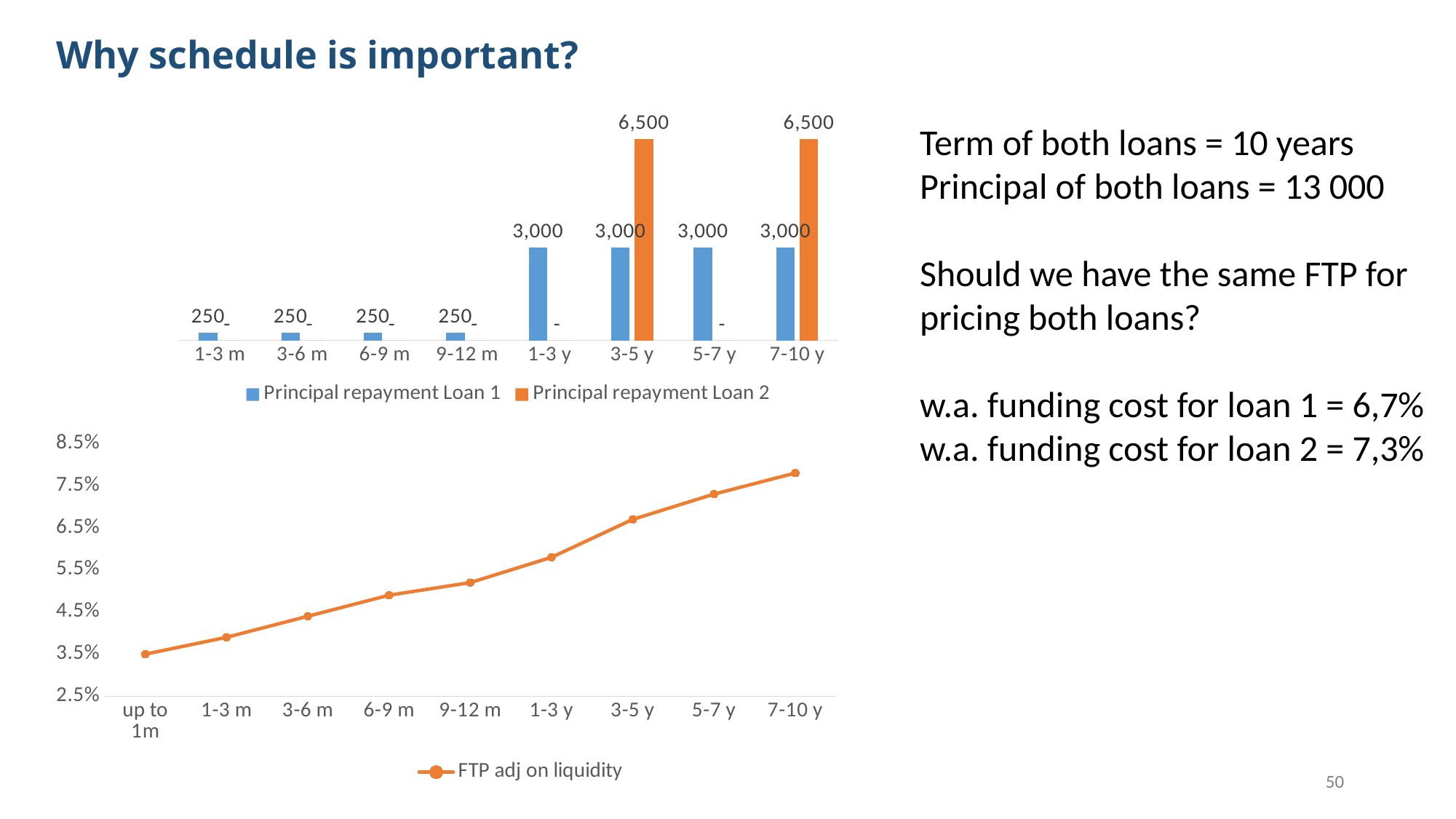
In the bottom line chart, is the FTP adj on liquidity value for 9-12 m greater or less than 5.5%? less In the top bar chart, what is the Principal repayment Loan 1 value for the 7-10 y bucket? 3,000 In the bottom line chart, is the FTP adj on liquidity value for 7-10 y greater or less than 7.5%? greater In the top bar chart, what is the difference between Principal repayment Loan 2 and Principal repayment Loan 1 in the 7-10 y bucket? 3,500 In the top bar chart, what is the Principal repayment Loan 2 value for the 3-5 y bucket? 6,500 How many series does the legend of the top bar chart list? 2 In the bottom line chart, does the FTP adj on liquidity rise or fall as the time bucket moves from up to 1m to 7-10 y? Rise How many time buckets are shown on the x axis of the top bar chart? 8 What kind of chart is the bottom chart on the slide? Line chart In the top bar chart, which series has the larger value in the 3-5 y bucket, Loan 1 or Loan 2? Principal repayment Loan 2 In the top bar chart, what is the Principal repayment Loan 1 value for the 1-3 m bucket? 250 What is the name of the series plotted in the bottom line chart? FTP adj on liquidity